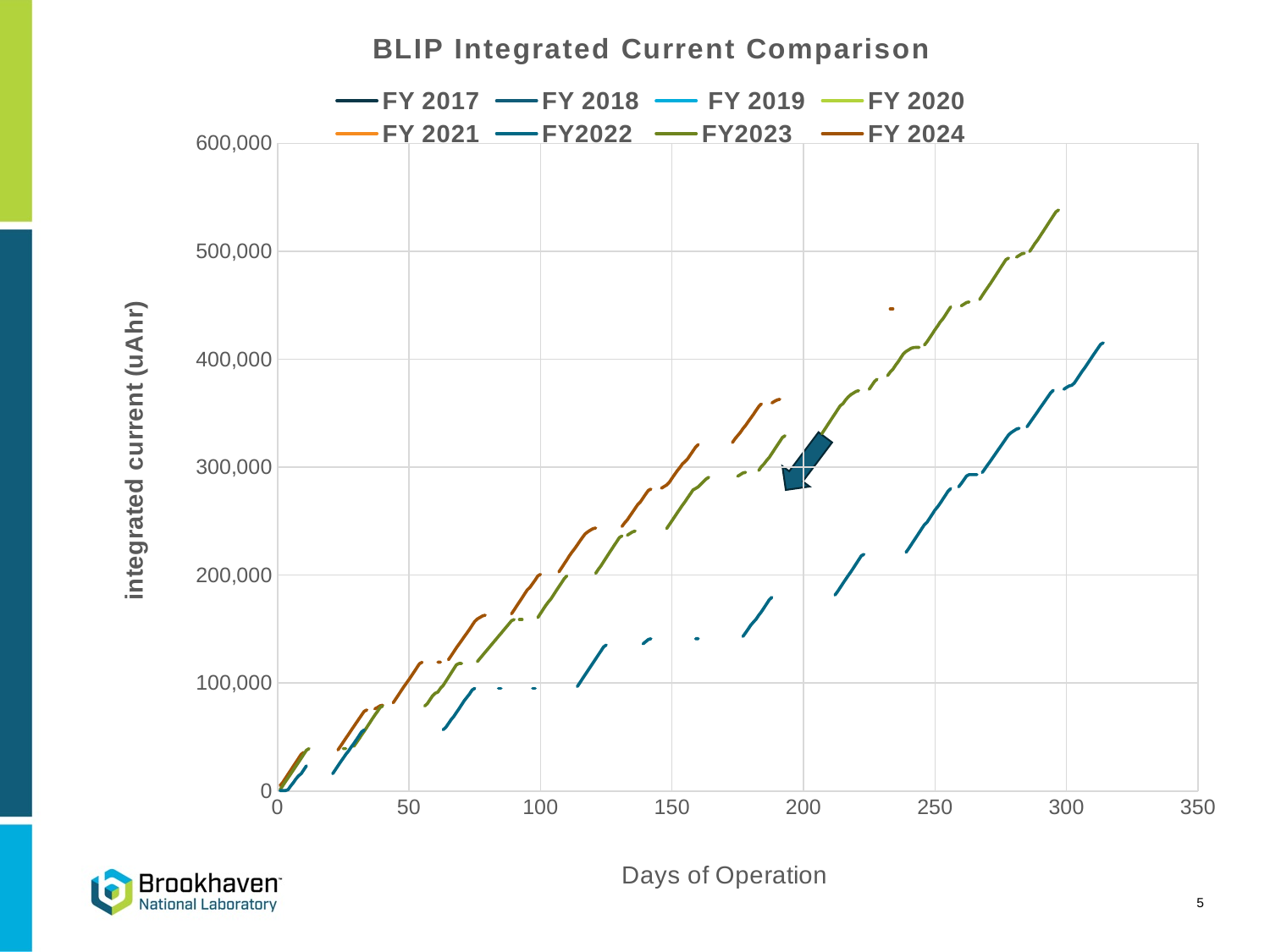
Do the plotted lines rise or fall as Days of Operation increases? rise Is the value of the FY2023 line at 250 days of operation greater or less than 400,000? greater Is the highest value reached by any line on the chart greater or less than 600,000? less Is the value of the FY 2024 line at 100 days of operation greater or less than 300,000? less Which series reaches the highest integrated current on the chart, FY2023 or FY 2024? FY2023 How many series does the legend list? 8 What is the label of the vertical axis? integrated current (uAhr) What is the title of the chart? BLIP Integrated Current Comparison What kind of chart is shown on the slide? line chart